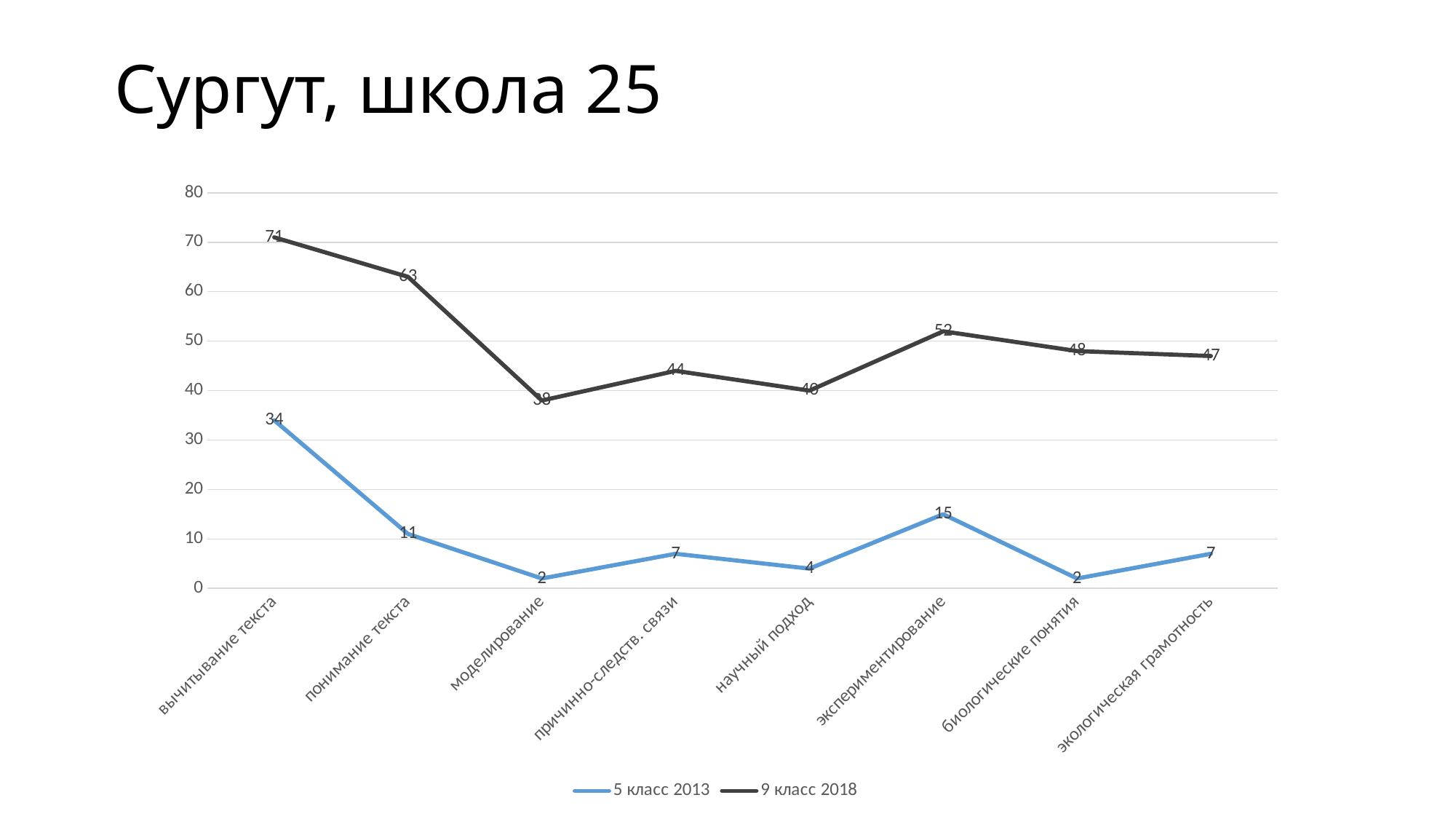
Which category has the highest value in the 5 класс 2013 series? вычитывание текста Does the 5 класс 2013 series rise or fall from вычитывание текста to моделирование? fall What is the value for экспериментирование in the 5 класс 2013 series? 15 How many series does the legend list? 2 What is the value for причинно-следств. связи in the 9 класс 2018 series? 44 What is the difference between the 9 класс 2018 and 5 класс 2013 values for вычитывание текста? 37 Which is larger for экспериментирование: the 5 класс 2013 value or the 9 класс 2018 value? 9 класс 2018 Which category has the lowest value in the 9 класс 2018 series? моделирование What is the value for вычитывание текста in the 9 класс 2018 series? 71 How many categories are plotted along the x axis? 8 What type of chart is shown on the slide? line chart What is the title of the slide? Сургут, школа 25